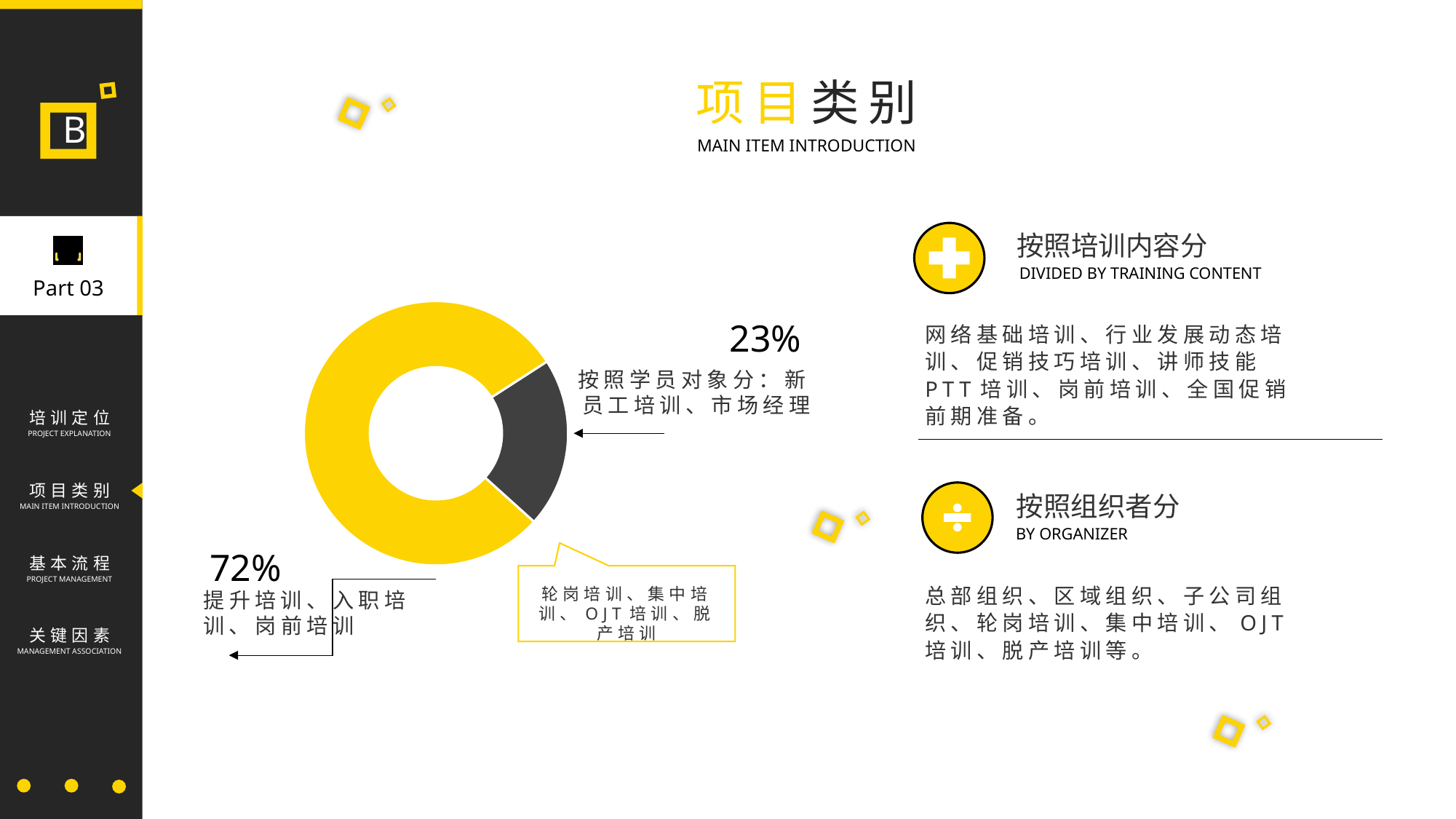
Which slice of the donut chart is the smallest? The dark grey slice (23%) What percentage is shown for the yellow slice of the donut chart? 72% Which is larger: the yellow slice or the dark grey slice? The yellow slice What is the difference between the 72% slice and the 23% slice? 49 percentage points How many slices does the donut chart have? 2 What share of the donut is labelled for the slice described as 提升培训、入职培训、岗前培训? 72% Is the yellow slice's share greater or less than 50%? greater What percentage is shown for the dark grey slice of the donut chart? 23% What kind of chart is shown on the slide? Donut (pie) chart Which slice of the donut chart is the largest? The yellow slice (72%) What colour is the slice labelled 23%? Dark grey What is the title of the slide containing the donut chart? 项目类别 (MAIN ITEM INTRODUCTION)